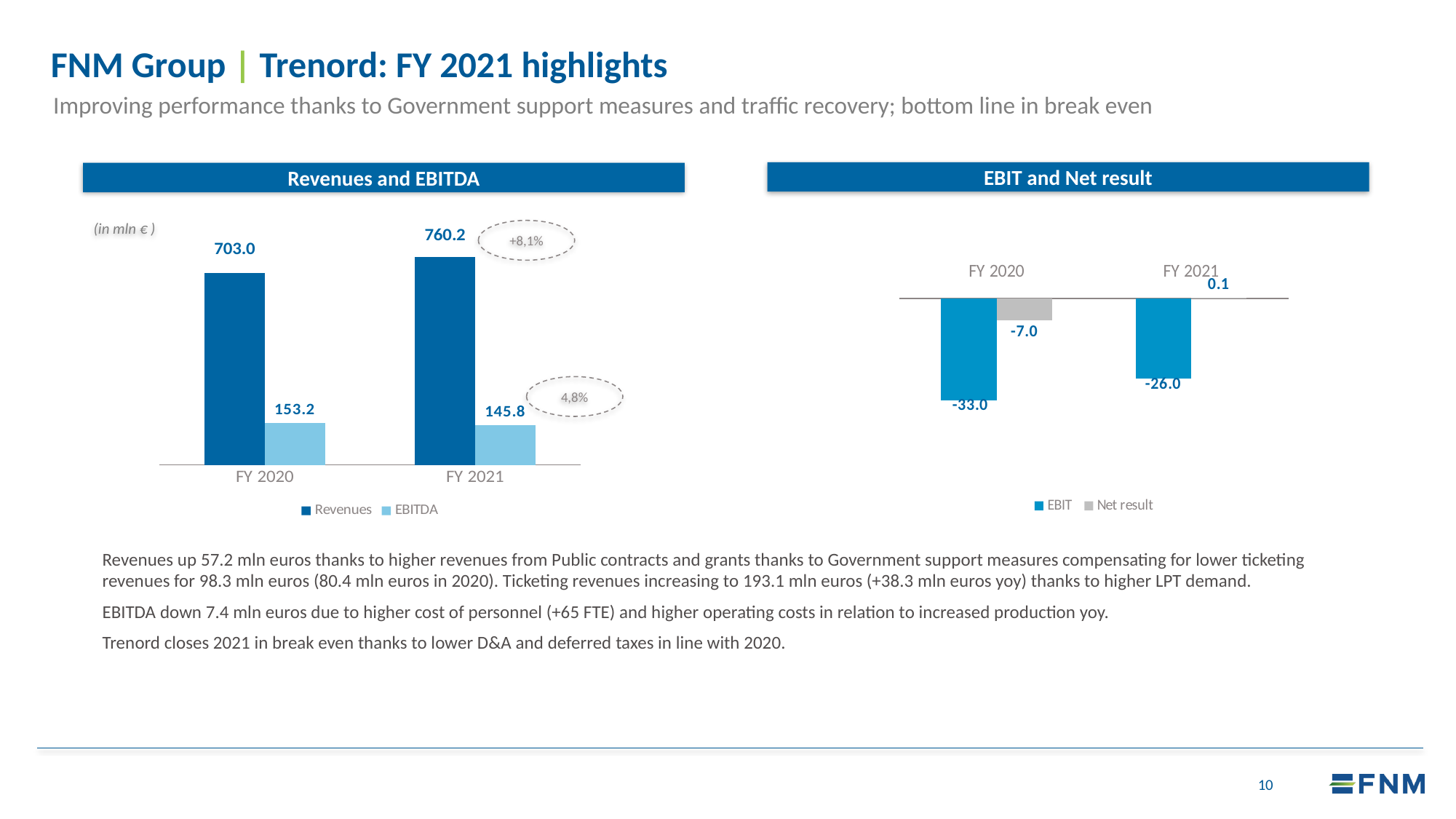
In the 'Revenues and EBITDA' chart, what is the difference between Revenues in FY 2021 and FY 2020? 57.2 In the 'Revenues and EBITDA' chart, is EBITDA higher in FY 2020 or FY 2021? FY 2020 In the 'Revenues and EBITDA' chart, how many series does the legend list? 2 In the 'EBIT and Net result' chart, how many categories are shown on the x axis? 2 In the 'Revenues and EBITDA' chart, what is the value of EBITDA for FY 2020? 153.2 In the 'Revenues and EBITDA' chart, what is the value of Revenues for FY 2021? 760.2 In the 'Revenues and EBITDA' chart, what is the percentage change shown next to the FY 2021 Revenues bar? +8,1% What type of chart is the 'EBIT and Net result' chart? Bar chart In the 'EBIT and Net result' chart, what is the EBIT value for FY 2020? -33.0 In the 'EBIT and Net result' chart, what is the Net result for FY 2021? 0.1 In the 'EBIT and Net result' chart, what is the Net result for FY 2020? -7.0 In the 'EBIT and Net result' chart, what is the difference between EBIT in FY 2021 and FY 2020? 7.0